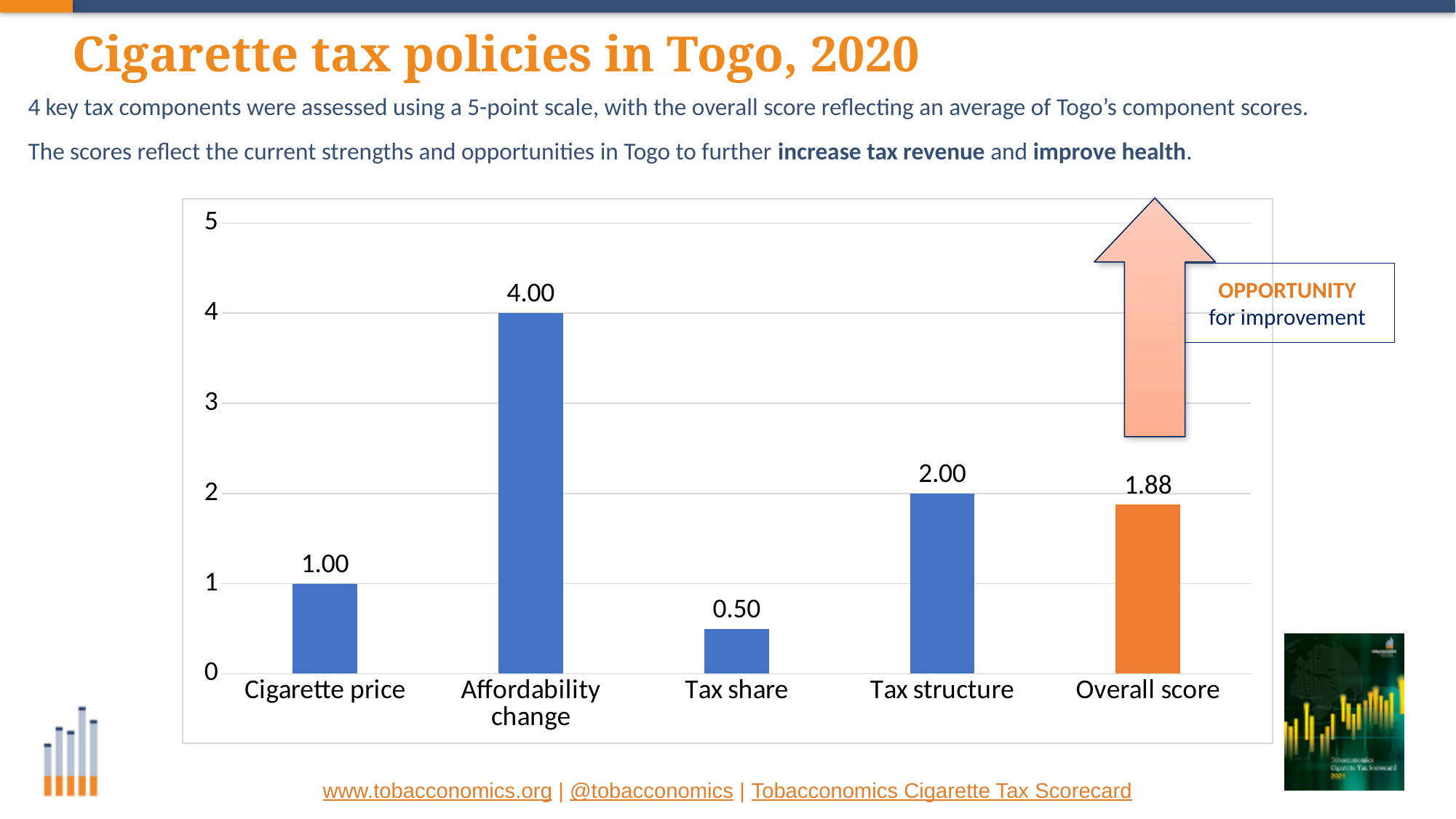
What kind of chart is shown on the slide? bar chart Which category has the lowest value? Tax share Is the value for Affordability change greater or less than 3? greater Which is larger, the value for Tax structure or the Overall score? Tax structure What is the value for Tax share? 0.50 What is the value for Cigarette price? 1.00 Which bar is coloured orange rather than blue? Overall score What is the difference between the values for Affordability change and Tax structure? 2.00 How many categories are shown on the x axis? 5 What is the value for Affordability change? 4.00 What is the Overall score? 1.88 Which category has the highest value? Affordability change